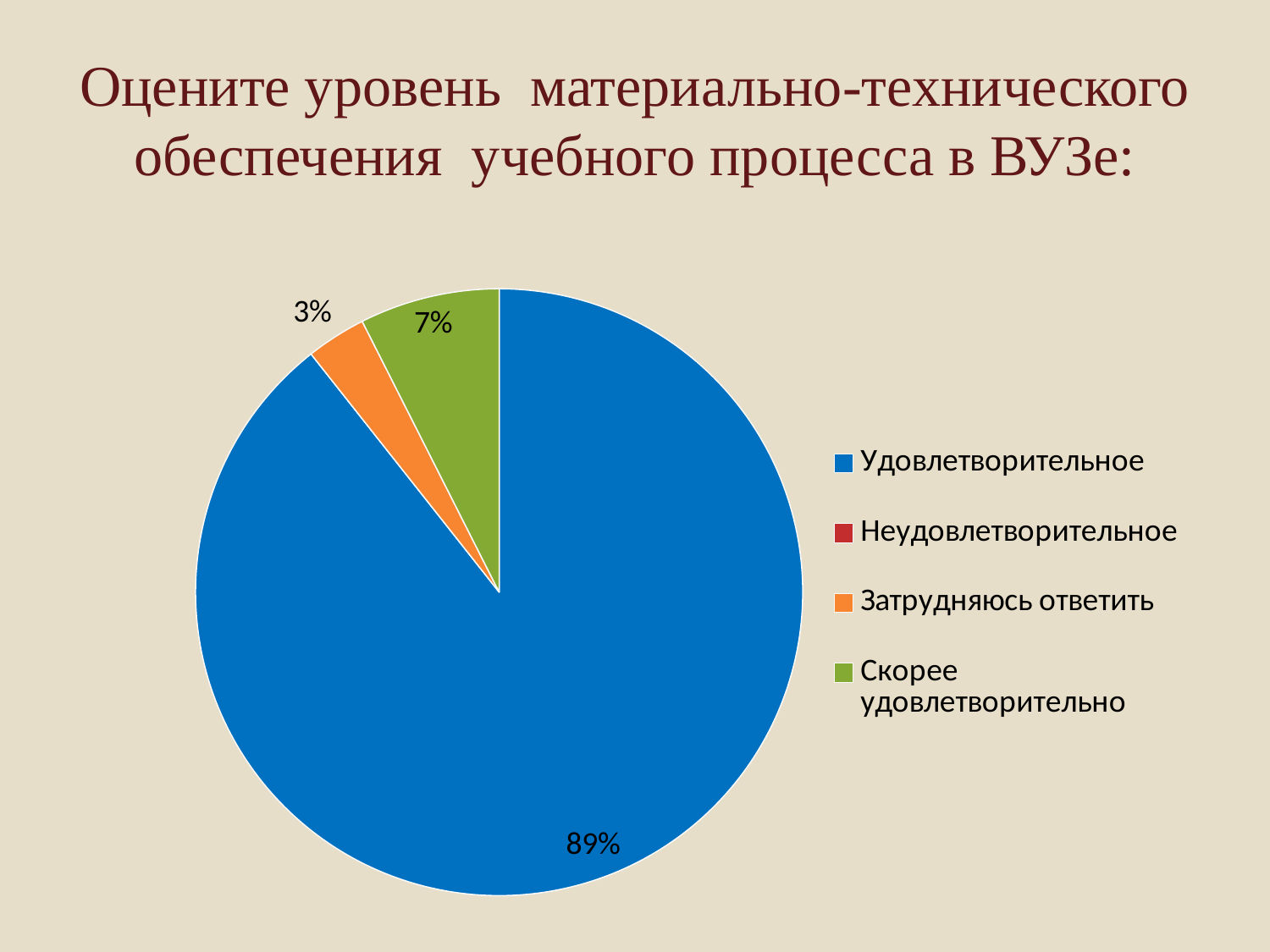
What type of chart is shown on the slide? Pie chart What colour is the slice for "Удовлетворительное"? Blue Which legend entry is shown in green? Скорее удовлетворительно What percentage of respondents answered "Скорее удовлетворительно"? 7% How many entries does the legend list? 4 Which category has the largest share of the pie? Удовлетворительное Which is larger: the share for "Скорее удовлетворительно" or the share for "Затрудняюсь ответить"? Скорее удовлетворительно What percentage of respondents answered "Удовлетворительное"? 89% What percentage of respondents answered "Затрудняюсь ответить"? 3% Which of the labelled slices is the smallest? Затрудняюсь ответить What is the difference in percentage points between "Удовлетворительное" and "Скорее удовлетворительно"? 82 percentage points What is the combined share of "Затрудняюсь ответить" and "Скорее удовлетворительно"? 10%